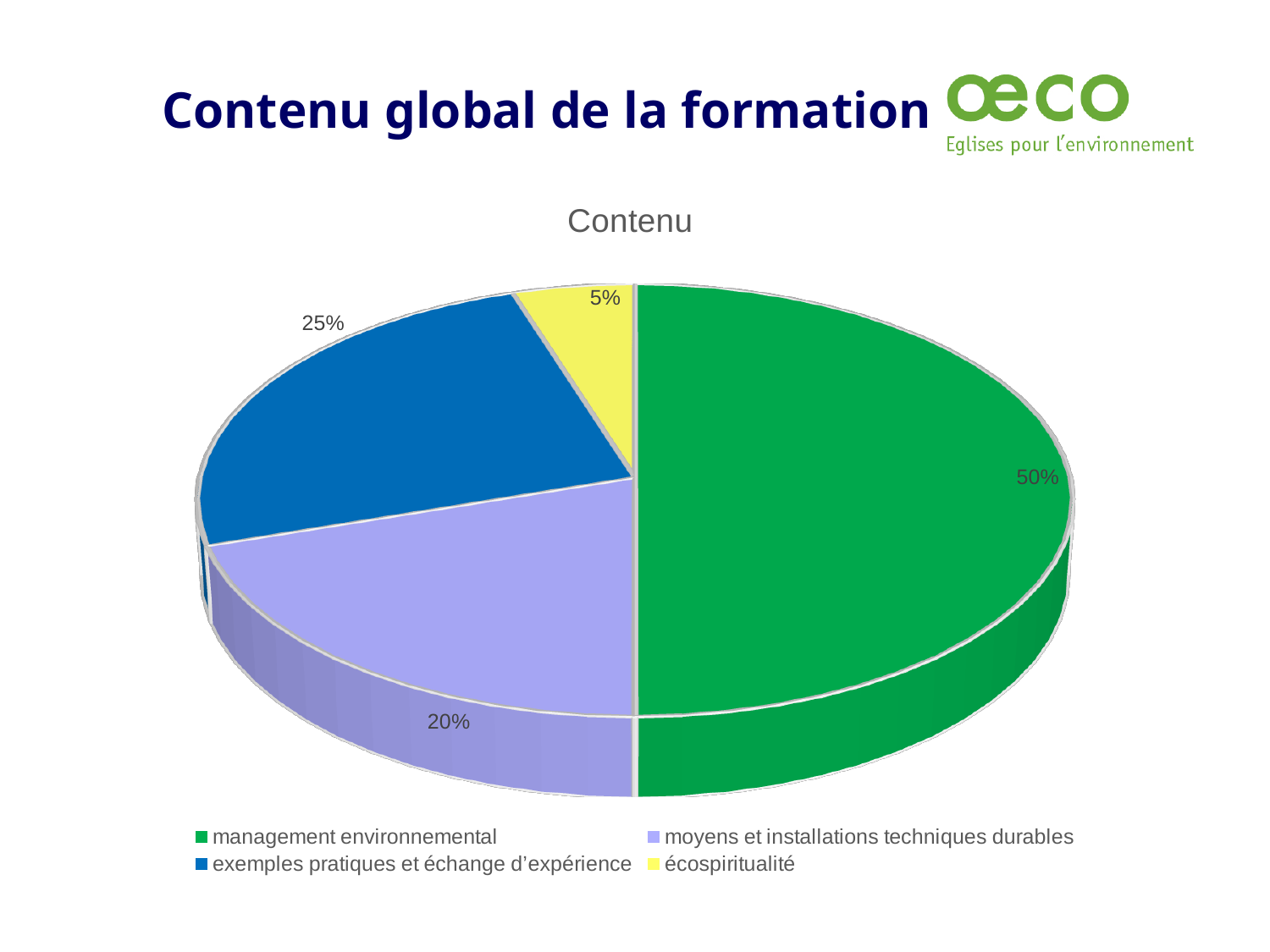
Which category has the smallest slice of the pie? écospiritualité What share of the pie does 'moyens et installations techniques durables' take? 20% How many categories does the pie chart have? 4 What colour is the slice for 'écospiritualité'? yellow What kind of chart is shown on the slide? pie chart Which category has the largest slice of the pie? management environnemental What is the difference between the shares of 'management environnemental' and 'exemples pratiques et échange d'expérience'? 25% What share of the pie does 'écospiritualité' take? 5% What share of the pie does 'management environnemental' take? 50% Which is larger: the share for 'exemples pratiques et échange d'expérience' or the share for 'moyens et installations techniques durables'? exemples pratiques et échange d'expérience What is the chart's title? Contenu What share of the pie does 'exemples pratiques et échange d'expérience' take? 25%